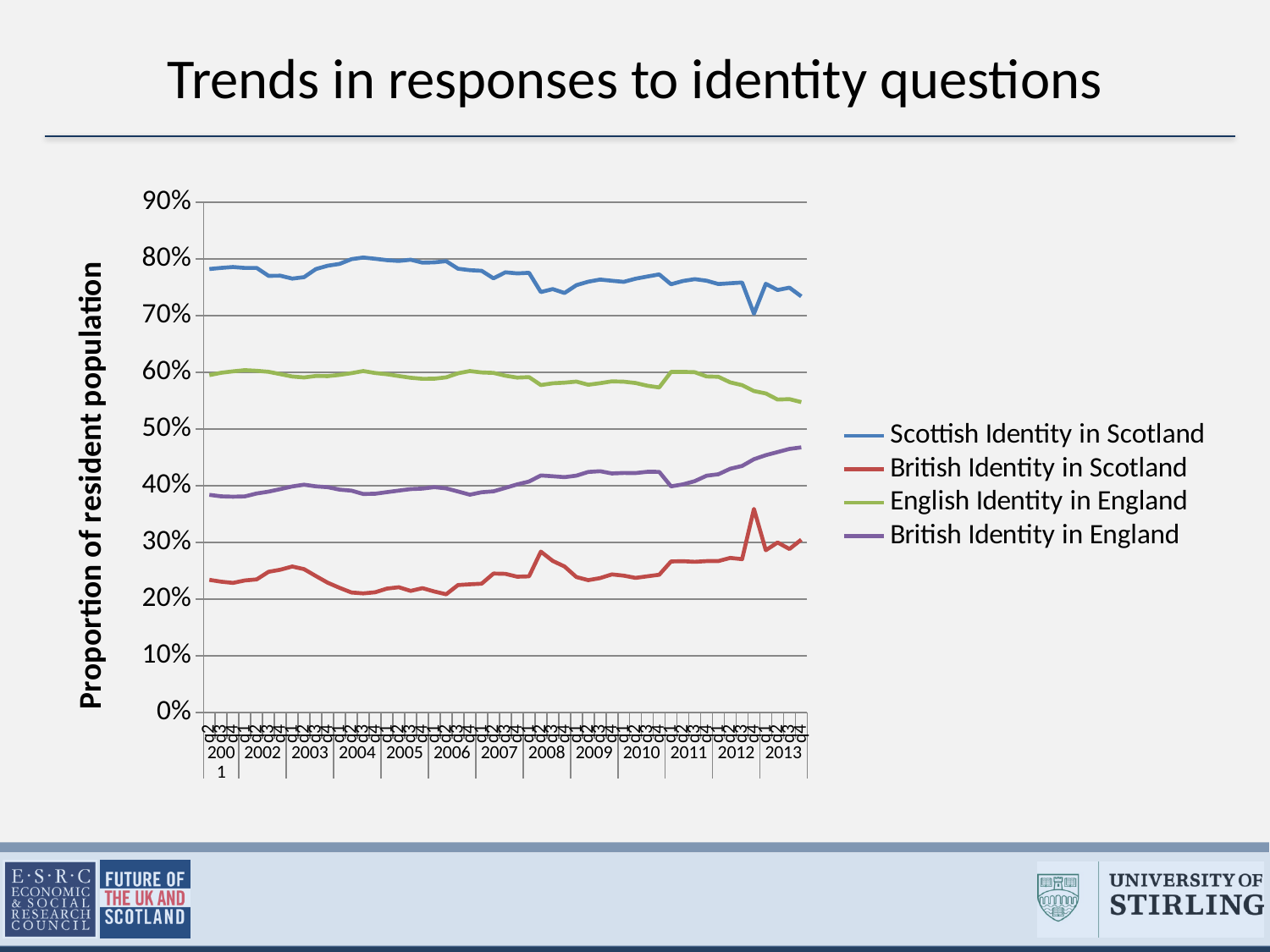
Is the value for British Identity in Scotland in 2001 greater or less than 30%? less Is the value for British Identity in England in 2001 greater or less than 30%? greater Which series has the highest values across the whole period? Scottish Identity in Scotland Which series has the lowest values across the whole period? British Identity in Scotland What kind of chart is shown on the slide? line chart Does the British Identity in England line rise or fall from 2001 to 2013? rise In 2013, which is larger: English Identity in England or British Identity in England? English Identity in England How many series does the legend list? 4 Is the value for English Identity in England in 2013 greater or less than 50%? greater Does the English Identity in England line rise or fall from 2001 to 2013? fall What is the label on the vertical axis? Proportion of resident population